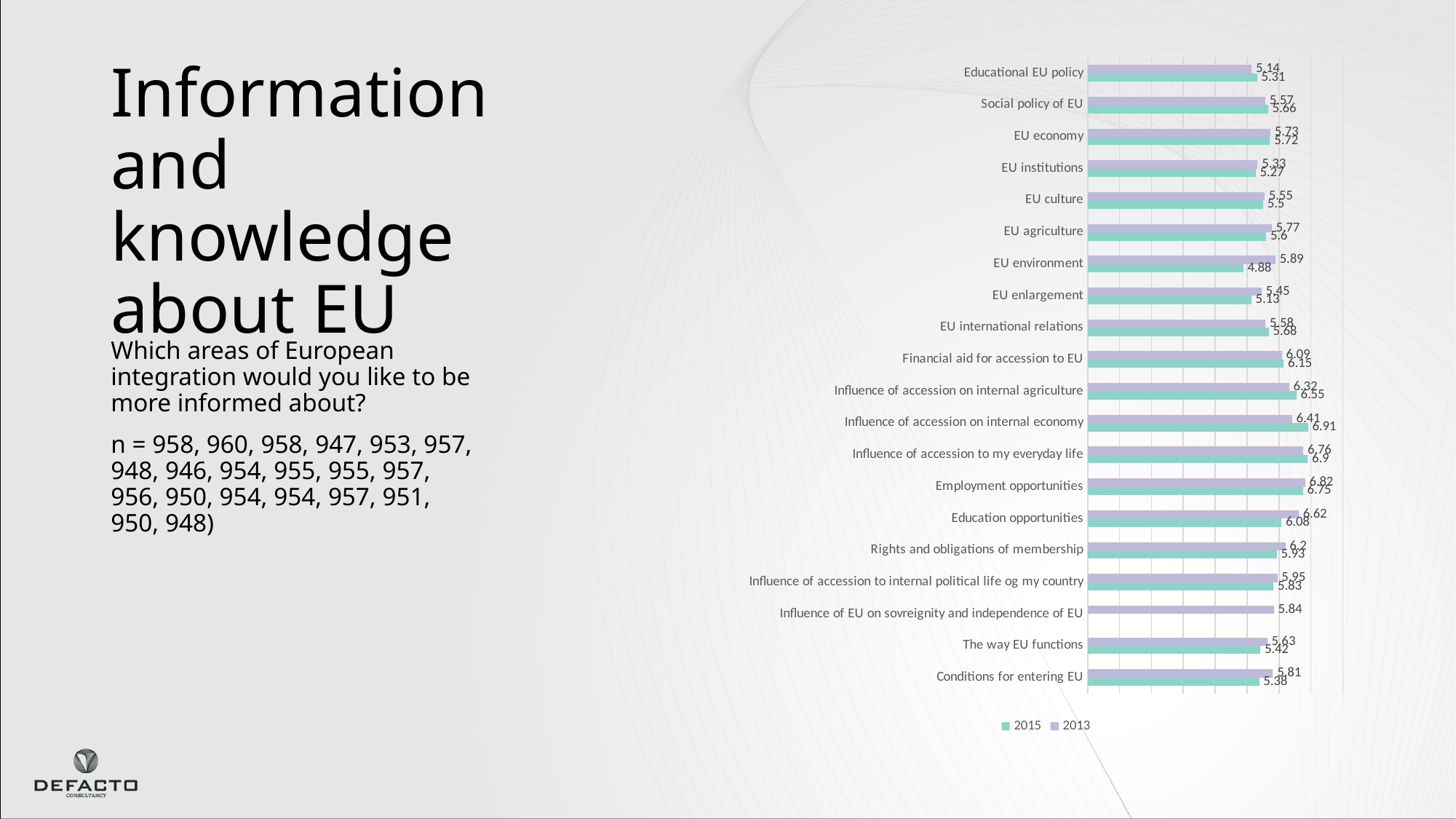
What kind of chart is shown on the slide? Bar chart What is the 2013 value for Employment opportunities? 6.82 What is the 2015 value for EU environment? 4.88 What is the 2015 value for Influence of accession on internal economy? 6.91 What is the 2013 value for Conditions for entering EU? 5.81 What is the difference between the 2013 and 2015 values for EU environment? 1.01 Which category has the highest 2015 value? Influence of accession on internal economy Which category has the lowest 2013 value? Educational EU policy How many categories are shown on the chart? 20 Which category has the lowest 2015 value? EU environment How many series does the legend list? 2 For Education opportunities, which year has the larger value, 2013 or 2015? 2013